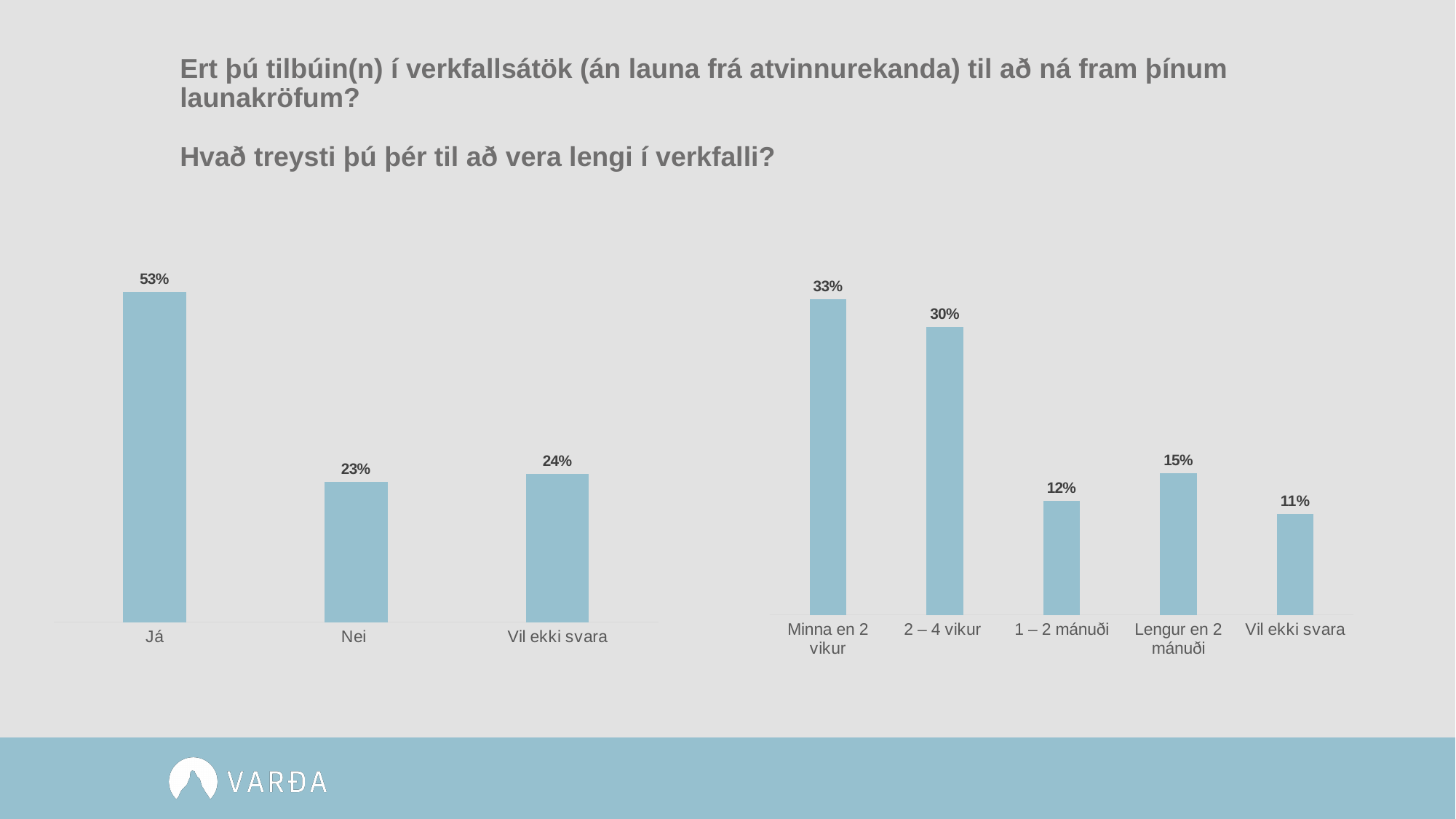
In the right chart, how many categories are shown? 5 In the left chart, which category has the highest value? Já In the right chart, what is the value for 2 – 4 vikur? 30% In the left chart, what is the value for Nei? 23% What type of chart is the left chart? Bar chart In the left chart, how many categories are shown? 3 In the right chart, what is the difference between Minna en 2 vikur and 1 – 2 mánuði? 21% In the right chart, what is the value for Lengur en 2 mánuði? 15% In the right chart, which category has the highest value? Minna en 2 vikur In the right chart, which category has the lowest value? Vil ekki svara In the left chart, what is the value for Já? 53% In the left chart, what is the difference between Já and Vil ekki svara? 29%